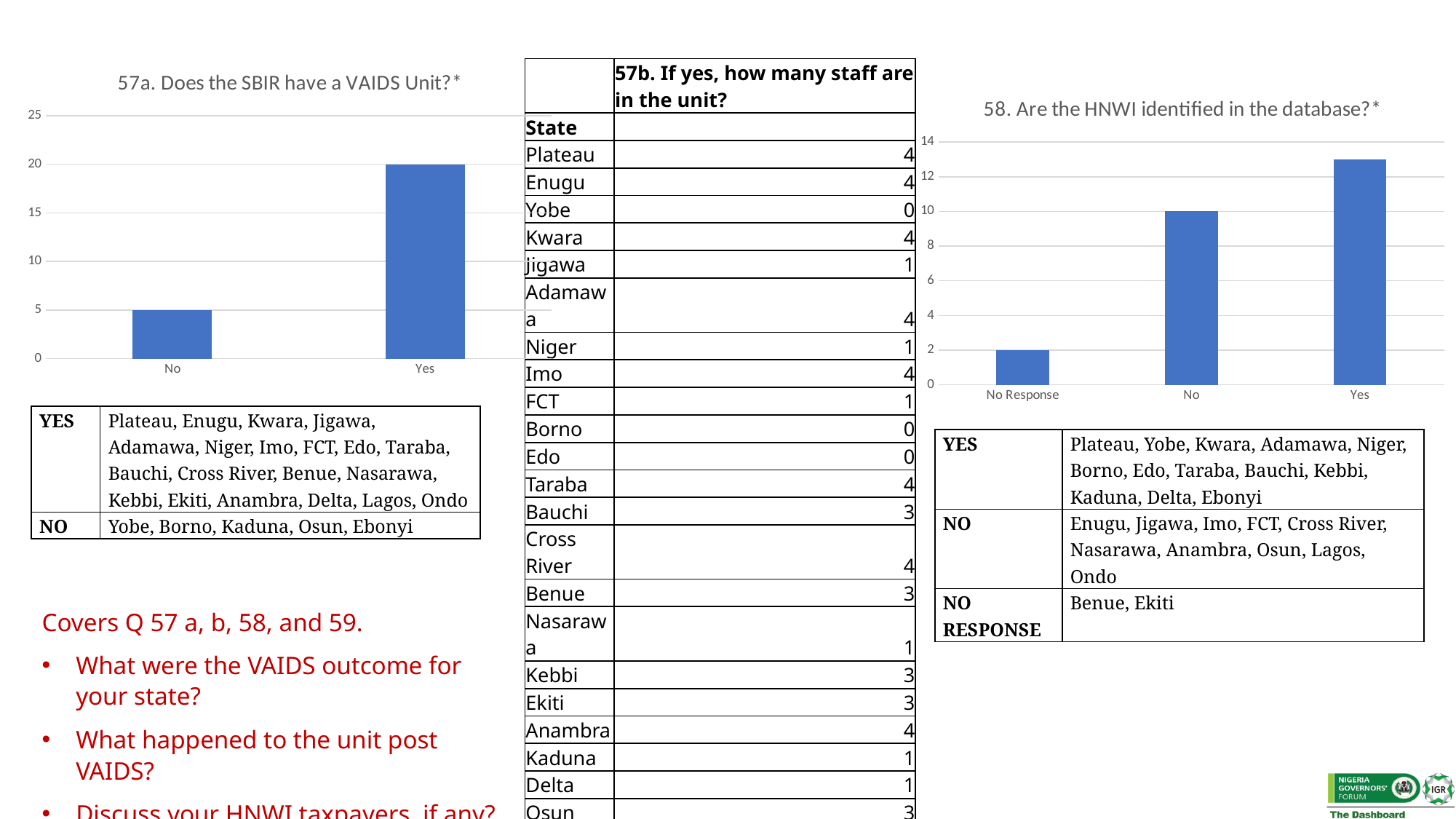
In the chart titled "58. Are the HNWI identified in the database?*", how many categories are shown on the x axis? 3 In the chart titled "58. Are the HNWI identified in the database?*", do the values rise or fall from left to right along the x axis? Rise In the chart titled "57a. Does the SBIR have a VAIDS Unit?*", what is the value for No? 5 In the chart titled "58. Are the HNWI identified in the database?*", which category has the lowest value? No Response In the chart titled "57a. Does the SBIR have a VAIDS Unit?*", which category has the highest value? Yes In the chart titled "57a. Does the SBIR have a VAIDS Unit?*", how many categories are shown on the x axis? 2 In the chart titled "57a. Does the SBIR have a VAIDS Unit?*", what is the value for Yes? 20 What kind of chart is the one titled "57a. Does the SBIR have a VAIDS Unit?*"? Bar chart In the chart titled "58. Are the HNWI identified in the database?*", is the value for Yes greater or less than 12? greater In the chart titled "58. Are the HNWI identified in the database?*", what is the value for No Response? 2 In the chart titled "58. Are the HNWI identified in the database?*", what is the value for No? 10 In the chart titled "57a. Does the SBIR have a VAIDS Unit?*", what is the difference between the Yes and No values? 15